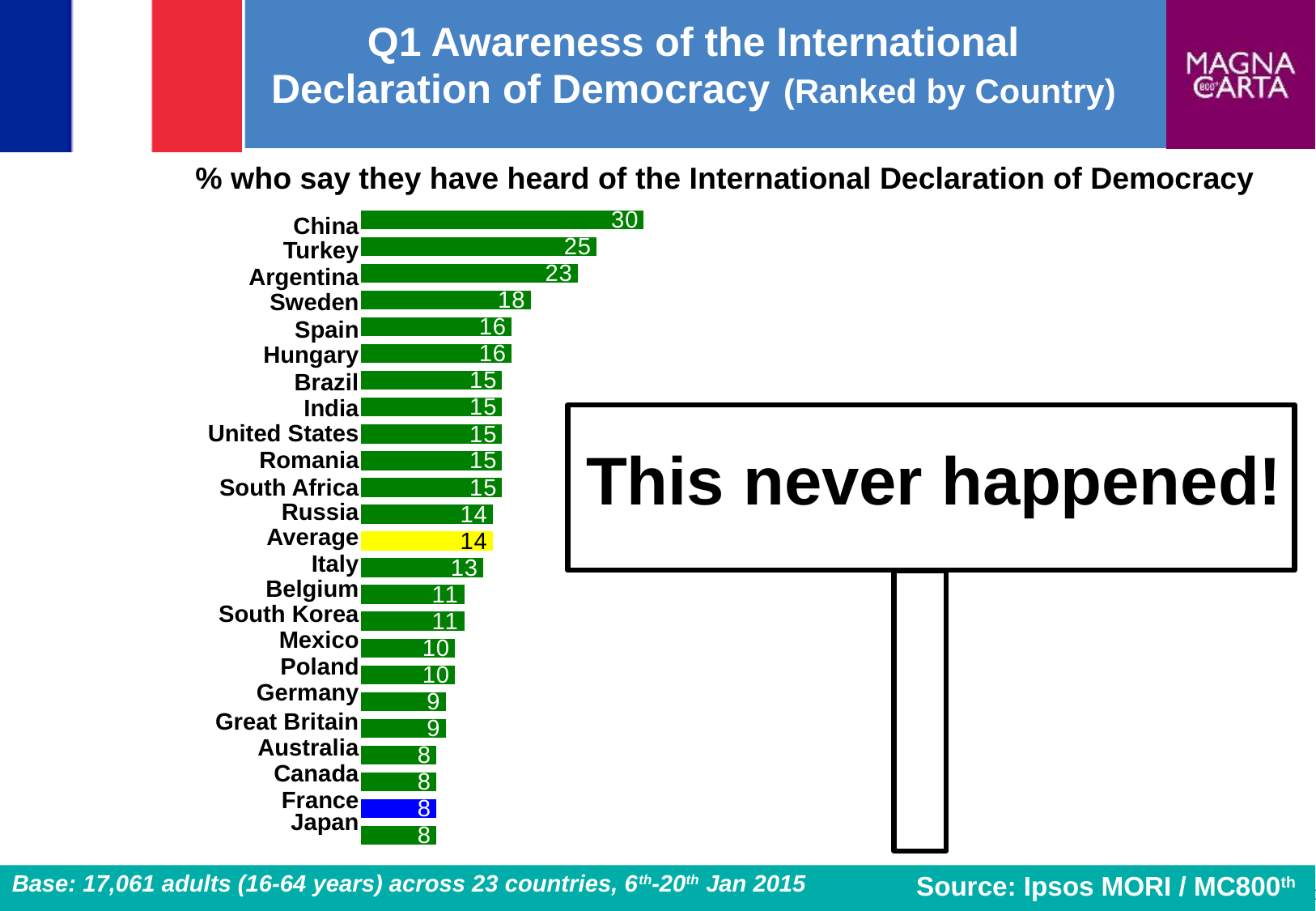
Which has a higher value, Argentina or Sweden? Argentina What type of chart is shown on the slide? Bar chart What is the value shown for Turkey? 25 Which country has the highest percentage who say they have heard of the International Declaration of Democracy? China What percentage of people in China say they have heard of the International Declaration of Democracy? 30 What is the value shown for Sweden? 18 What is the difference between the values for China and Turkey? 5 What is the value shown for France? 8 What is the value shown for the Average bar? 14 What colour is the bar for France? Blue How many bars are shown on the chart, including the Average bar? 24 What is the lowest value shown on the chart? 8